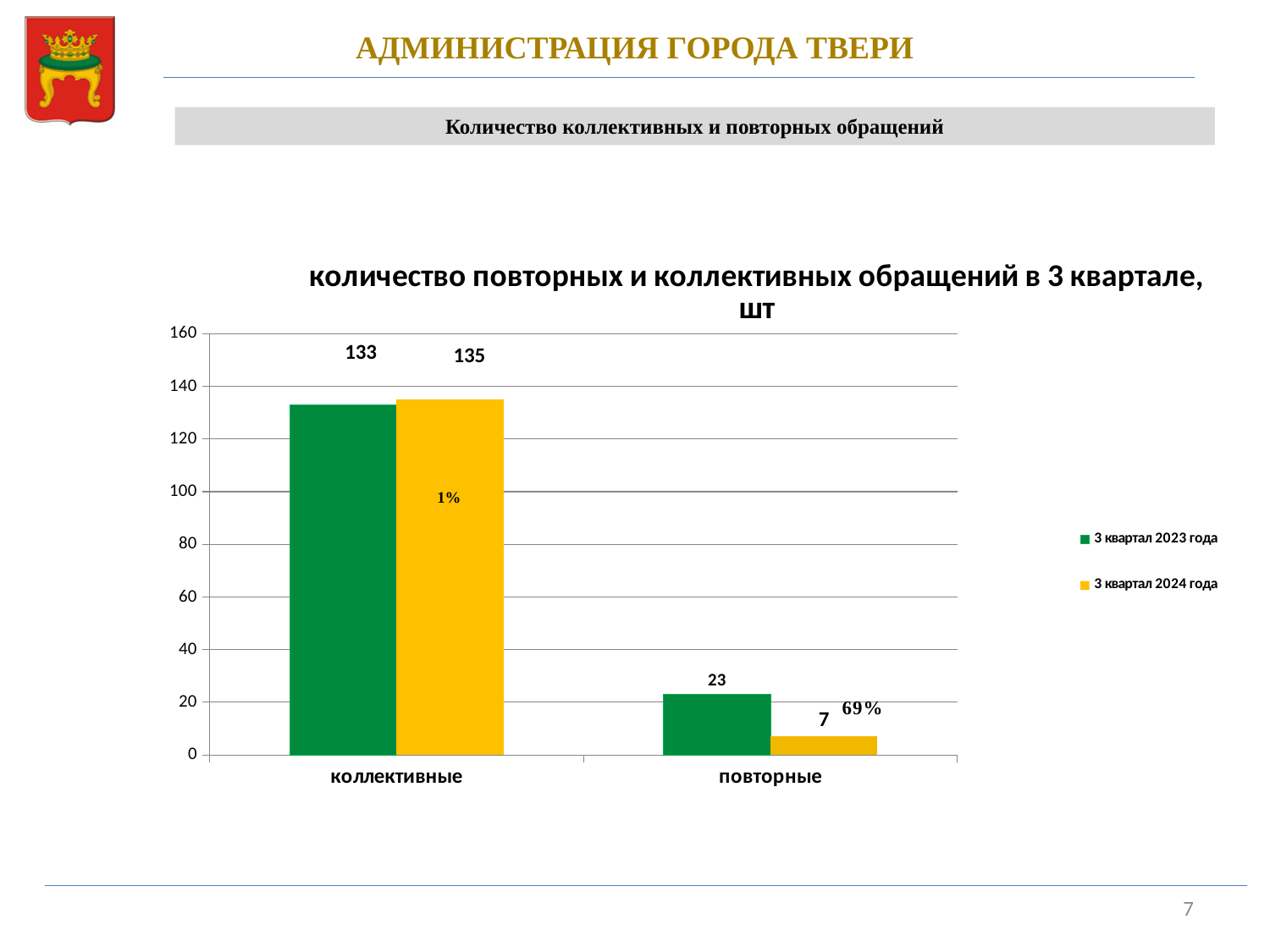
What is the difference between the 3 квартал 2024 года and 3 квартал 2023 года values for коллективные? 2 Which is larger for повторные: the 3 квартал 2023 года value or the 3 квартал 2024 года value? 3 квартал 2023 года What is the difference between the 3 квартал 2023 года and 3 квартал 2024 года values for повторные? 16 What kind of chart is shown on the slide? bar chart Which category has the highest value in the 3 квартал 2023 года series? коллективные Which category has the lowest value in the 3 квартал 2024 года series? повторные What is the value for коллективные in the 3 квартал 2023 года series? 133 How many categories are shown on the x axis? 2 What is the value for повторные in the 3 квартал 2023 года series? 23 How many series does the legend list? 2 What is the value for коллективные in the 3 квартал 2024 года series? 135 What is the value for повторные in the 3 квартал 2024 года series? 7